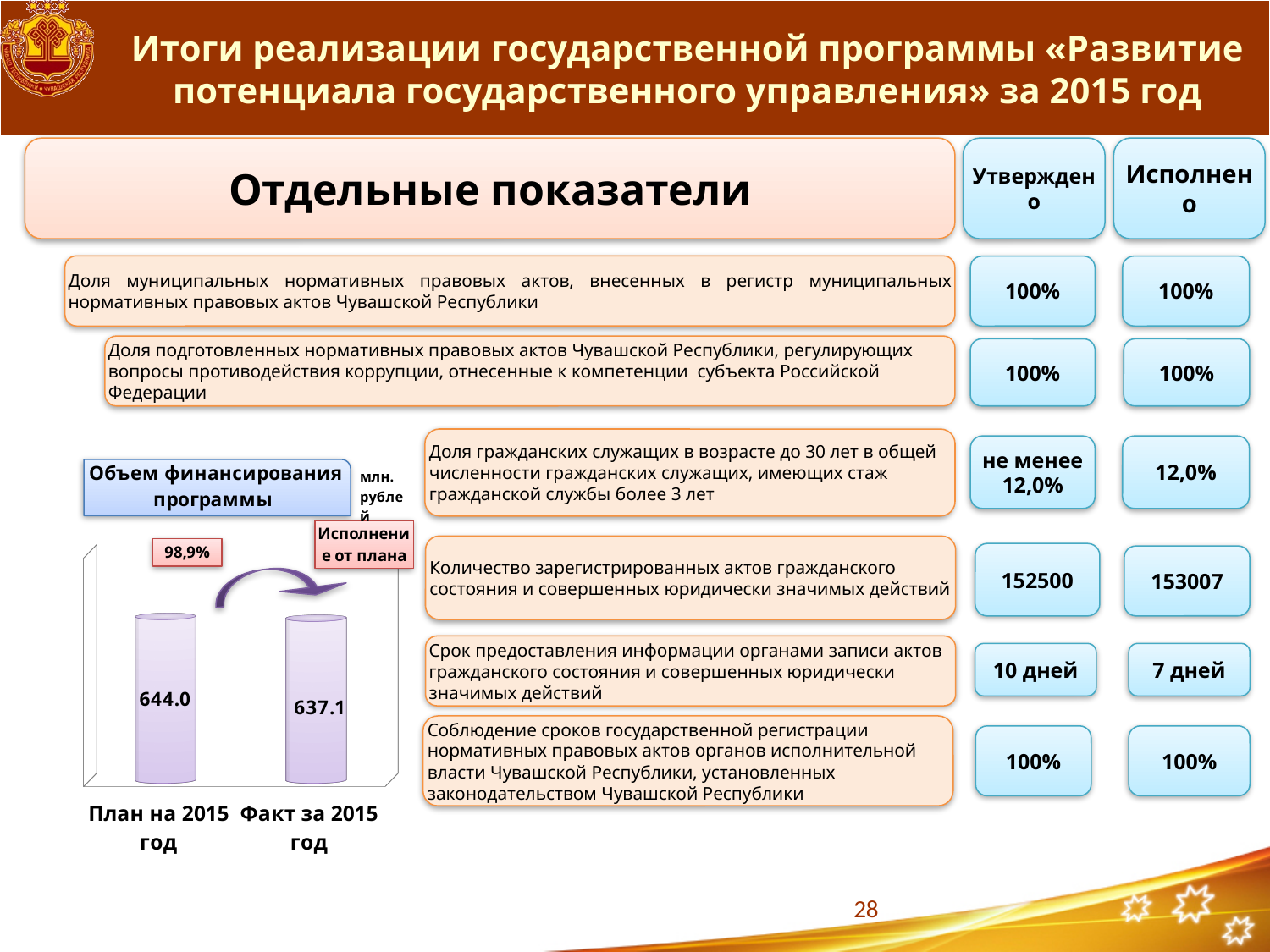
What unit of measurement is indicated for the «Объем финансирования программы» chart? млн. рублей What is the value for «Факт за 2015 год» in the «Объем финансирования программы» chart? 637.1 What is the difference between the plan and the actual value in the «Объем финансирования программы» chart? 6.9 In the «Объем финансирования программы» chart, is the value for «План на 2015 год» larger or smaller than the value for «Факт за 2015 год»? larger What type of chart is «Объем финансирования программы»? bar chart Do the values rise or fall from «План на 2015 год» to «Факт за 2015 год» in the «Объем финансирования программы» chart? fall How many bars are shown in the «Объем финансирования программы» chart? 2 What percentage of plan fulfilment («Исполнение от плана») is shown on the «Объем финансирования программы» chart? 98,9% Which category has the lower value in the «Объем финансирования программы» chart? Факт за 2015 год What is the value for «План на 2015 год» in the «Объем финансирования программы» chart? 644.0 Which category has the higher value in the «Объем финансирования программы» chart? План на 2015 год